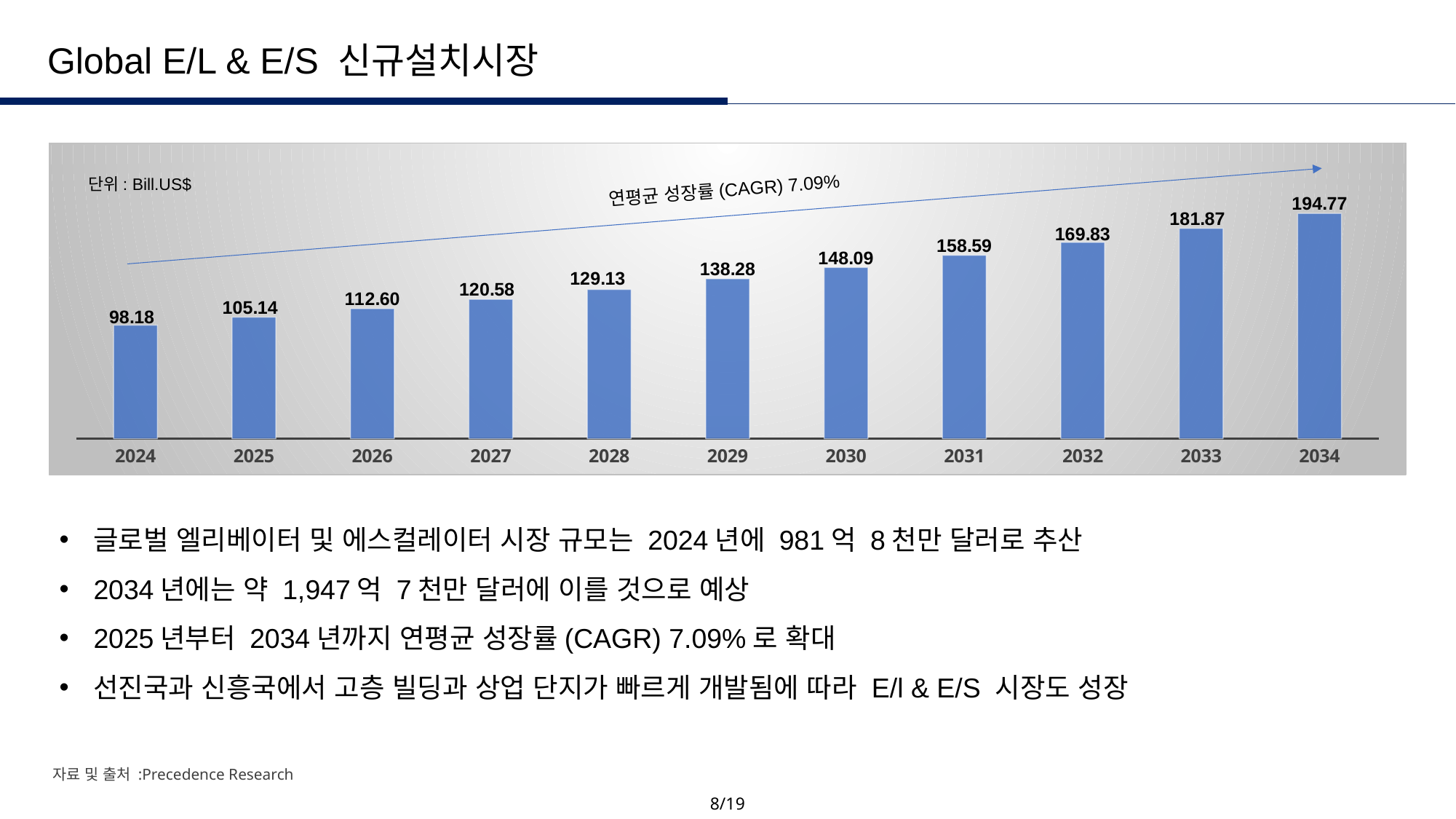
What CAGR is written above the bars? 7.09% Which year has the highest value? 2034 What is the value for 2024? 98.18 What is the difference between the values for 2026 and 2025? 7.46 How many years are shown on the x axis? 11 Which year has the lowest value? 2024 What is the value for 2034? 194.77 What kind of chart is this? bar chart What is the value for 2030? 148.09 Which is larger, the value for 2029 or the value for 2031? 2031 Do the values rise or fall from 2024 to 2034? rise What is the difference between the values for 2034 and 2024? 96.59